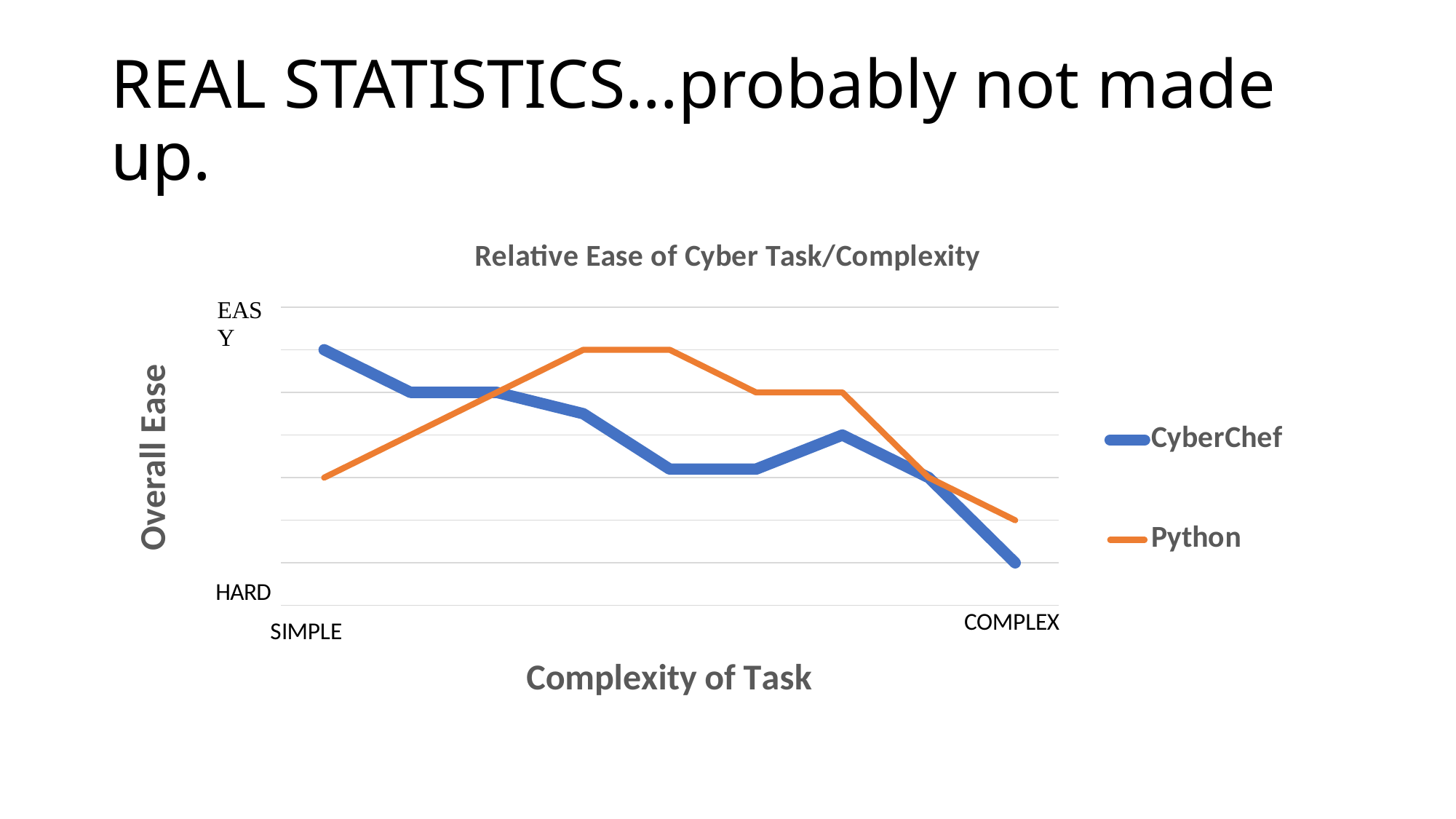
How many series does the legend list? 2 At the SIMPLE end of the x axis, which series is higher, CyberChef or Python? CyberChef Does the CyberChef line overall rise or fall from SIMPLE to COMPLEX? Fall Which series is drawn in blue? CyberChef What kind of chart is shown on the slide? Line chart Which series ends lowest at the COMPLEX end of the chart? CyberChef At the COMPLEX end of the x axis, which series is higher, CyberChef or Python? Python Does the Python line rise or fall between its first and second points? Rise Which series starts lowest at the SIMPLE end of the chart? Python What is the title of the chart? Relative Ease of Cyber Task/Complexity